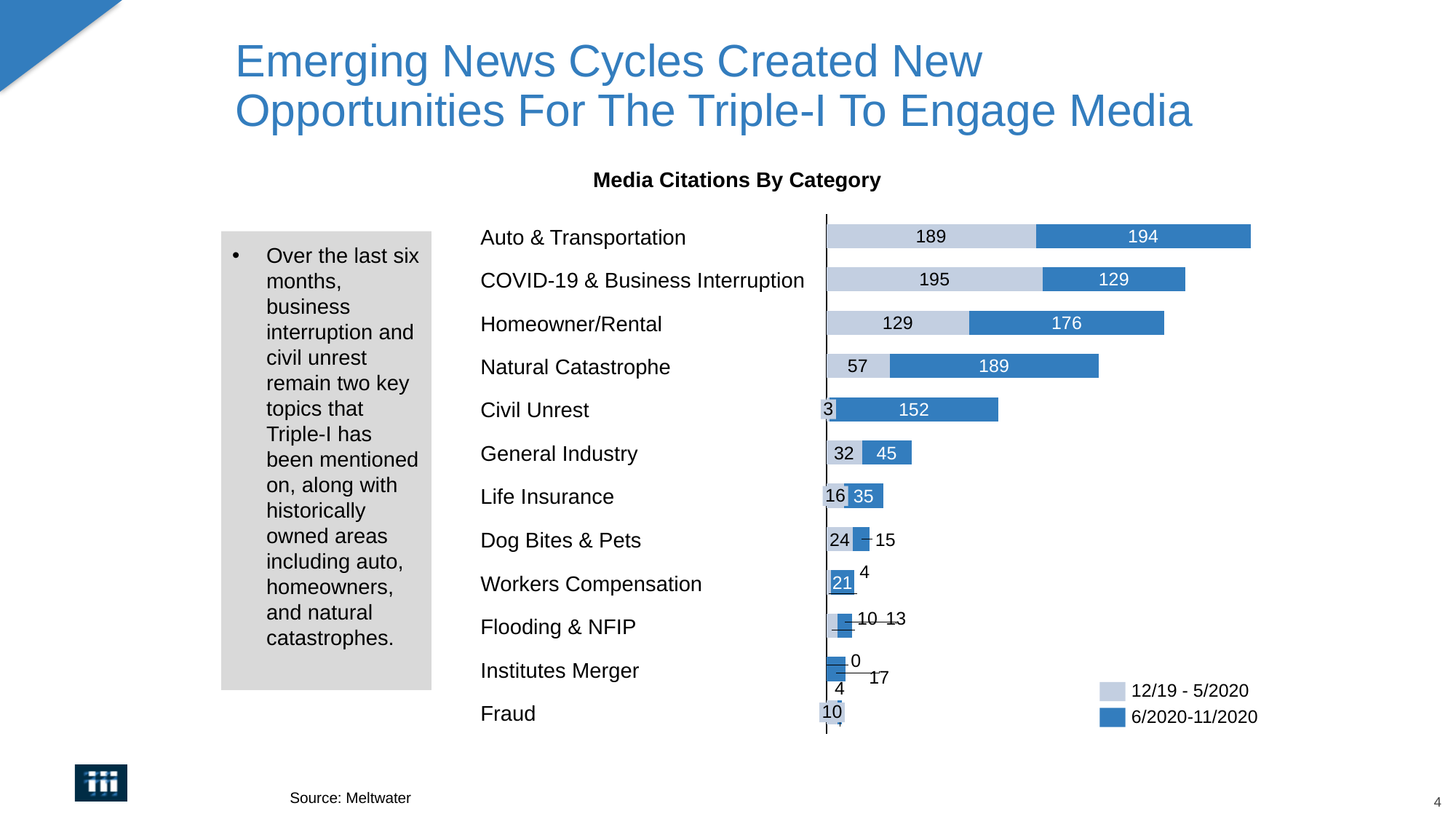
What is the 12/19 - 5/2020 value for COVID-19 & Business Interruption? 195 How many categories are shown in the chart? 12 Which is larger for General Industry: the 12/19 - 5/2020 value or the 6/2020-11/2020 value? 6/2020-11/2020 What is the difference between the 6/2020-11/2020 and 12/19 - 5/2020 values for Natural Catastrophe? 132 What is the total of the stacked bar for Homeowner/Rental? 305 What kind of chart is shown on the slide? Stacked bar chart What is the 12/19 - 5/2020 value for Civil Unrest? 3 Which category has the highest 12/19 - 5/2020 value? COVID-19 & Business Interruption What is the title of the chart? Media Citations By Category What is the 6/2020-11/2020 value for Natural Catastrophe? 189 How many series does the legend list? 2 What is the 6/2020-11/2020 value for Auto & Transportation? 194